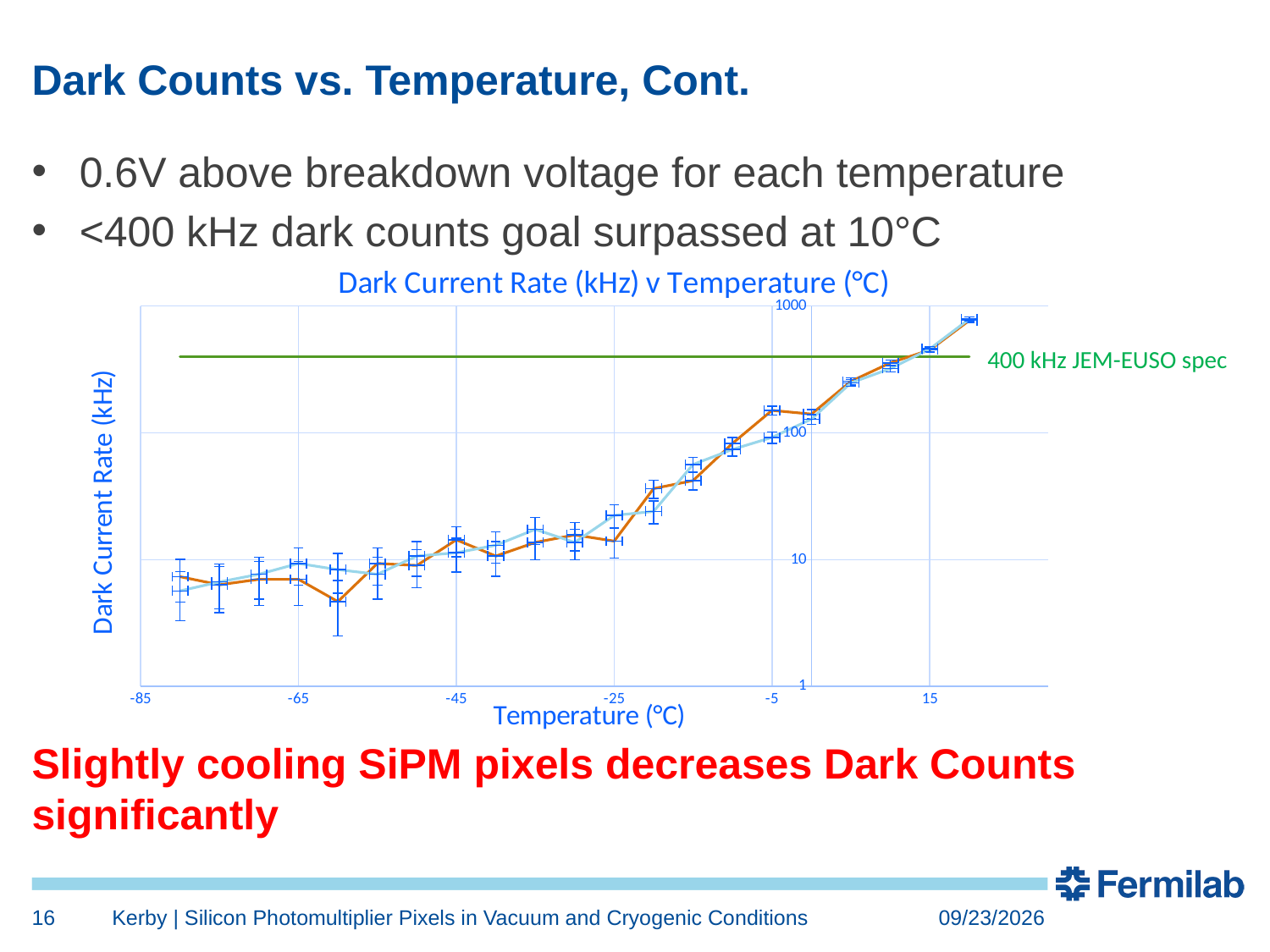
What is the label of the y axis of the chart? Dark Current Rate (kHz) What is the highest temperature tick shown on the x axis? 15 Is the dark current rate at -5°C greater or less than 10 kHz? greater What is the title of the chart? Dark Current Rate (kHz) v Temperature (°C) Is the dark current rate at -45°C greater or less than 100 kHz? less What kind of chart is shown on the slide? line chart Is the dark current rate at 15°C greater or less than 100 kHz? greater Which temperature has the higher dark current rate, -45°C or 15°C? 15°C Does the dark current rate rise or fall as temperature increases along the x axis? rise